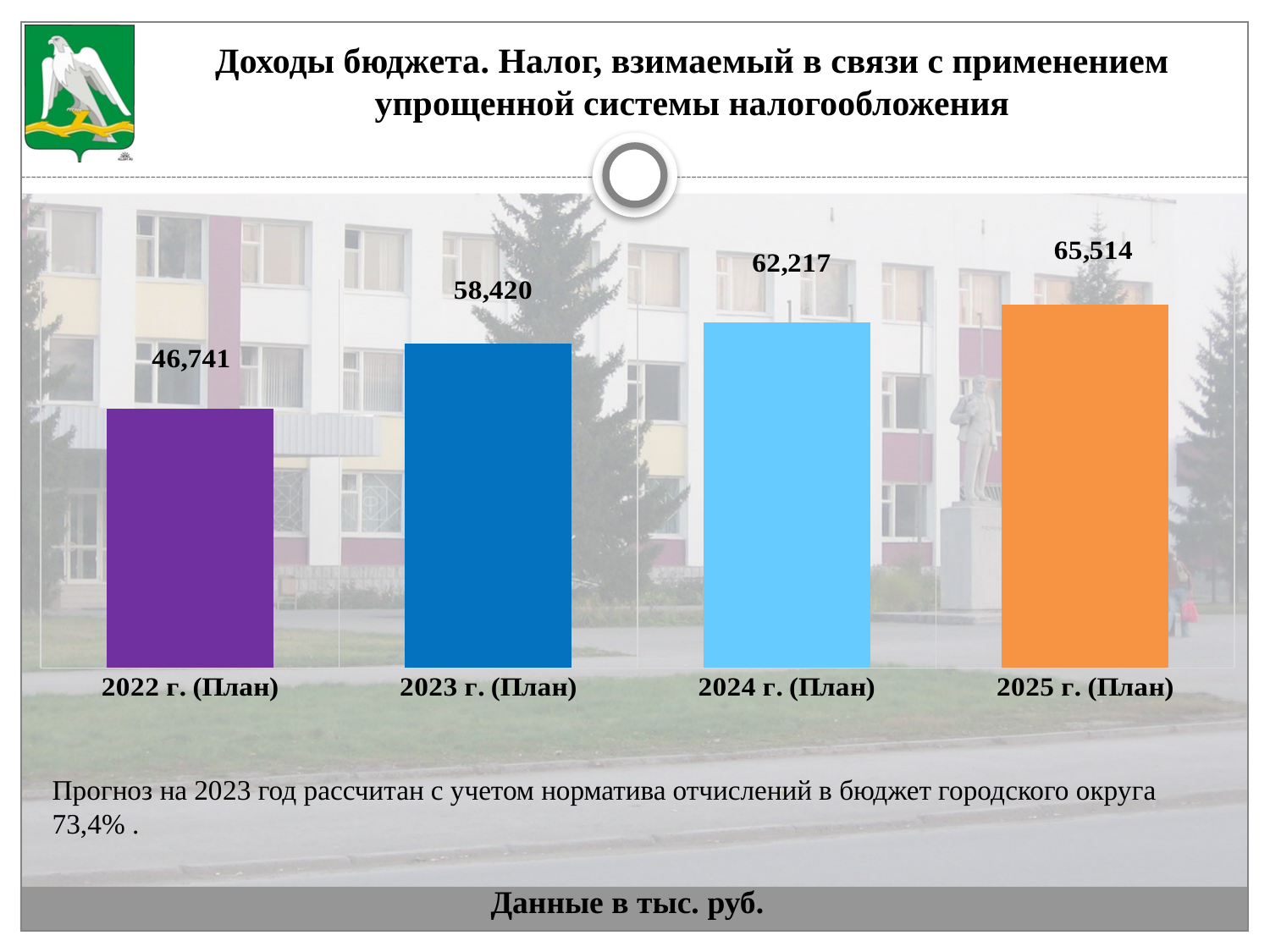
Which year has the highest value? 2025 г. (План) Which is larger, the value for 2024 г. (План) or the value for 2023 г. (План)? 2024 г. (План) How many bars are shown in the chart? 4 What kind of chart is shown on the slide? Bar chart What is the value for 2022 г. (План)? 46,741 What is the value for 2025 г. (План)? 65,514 Do the values rise or fall from 2022 to 2025? Rise What is the difference between the values for 2023 г. (План) and 2022 г. (План)? 11,679 Which year has the lowest value? 2022 г. (План) What is the value for 2024 г. (План)? 62,217 What is the value for 2023 г. (План)? 58,420 What is the difference between the values for 2025 г. (План) and 2024 г. (План)? 3,297